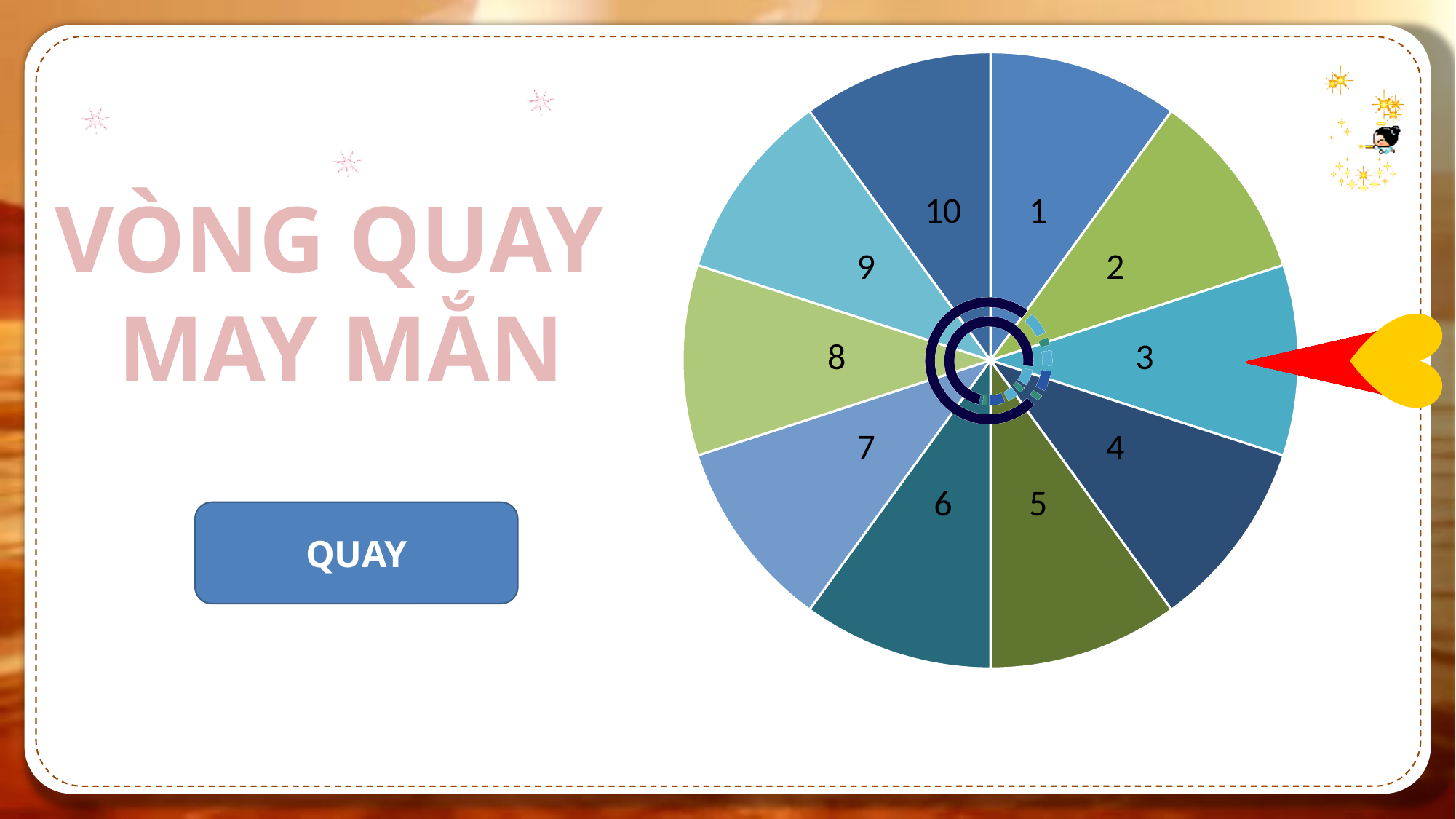
What is the label of the slice the red arrow points to? 3 What is the title shown on the left of the slide? VÒNG QUAY MAY MẮN What is the lowest number labelled on the wheel? 1 What is the highest number labelled on the wheel? 10 Which slice label is next to slice 10 going clockwise? 1 Which slice label sits between slices 4 and 6 on the wheel? 5 How many slices does the wheel have? 10 Which slice label is directly opposite slice 3 on the wheel? 8 What kind of chart is the wheel on the slide? pie chart